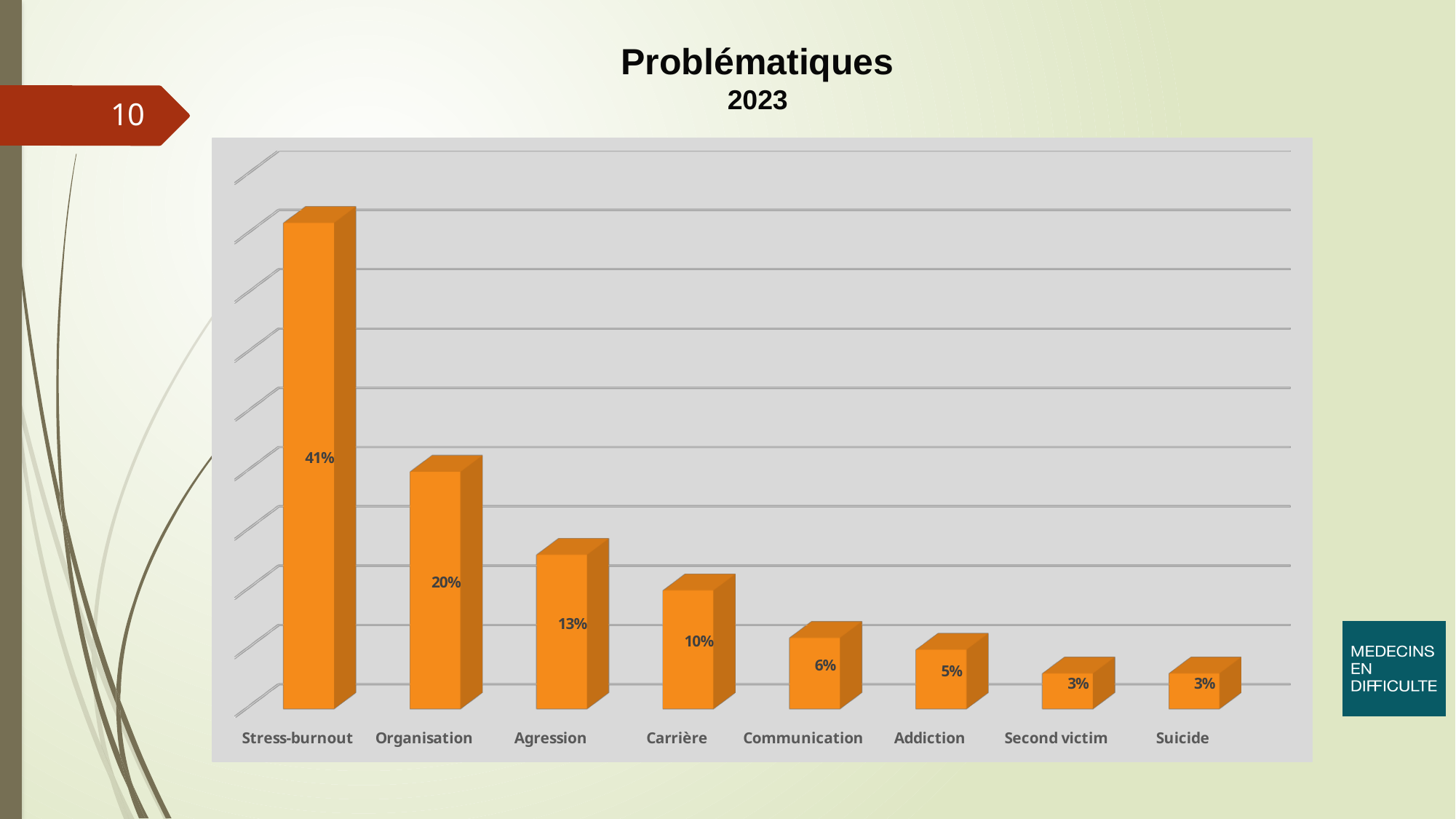
What is the value for Agression? 13% Which category has the highest value? Stress-burnout What is the difference between the values for Carrière and Addiction? 5% How many categories are shown on the chart? 8 What is the title of the chart? Problématiques 2023 What is the difference between the values for Stress-burnout and Organisation? 21% Which is larger, the value for Agression or the value for Carrière? Agression What is the value for Communication? 6% What is the value for Organisation? 20% Do the values rise or fall from left to right along the x axis? Fall What kind of chart is shown on the slide? Bar chart What is the value for Stress-burnout? 41%